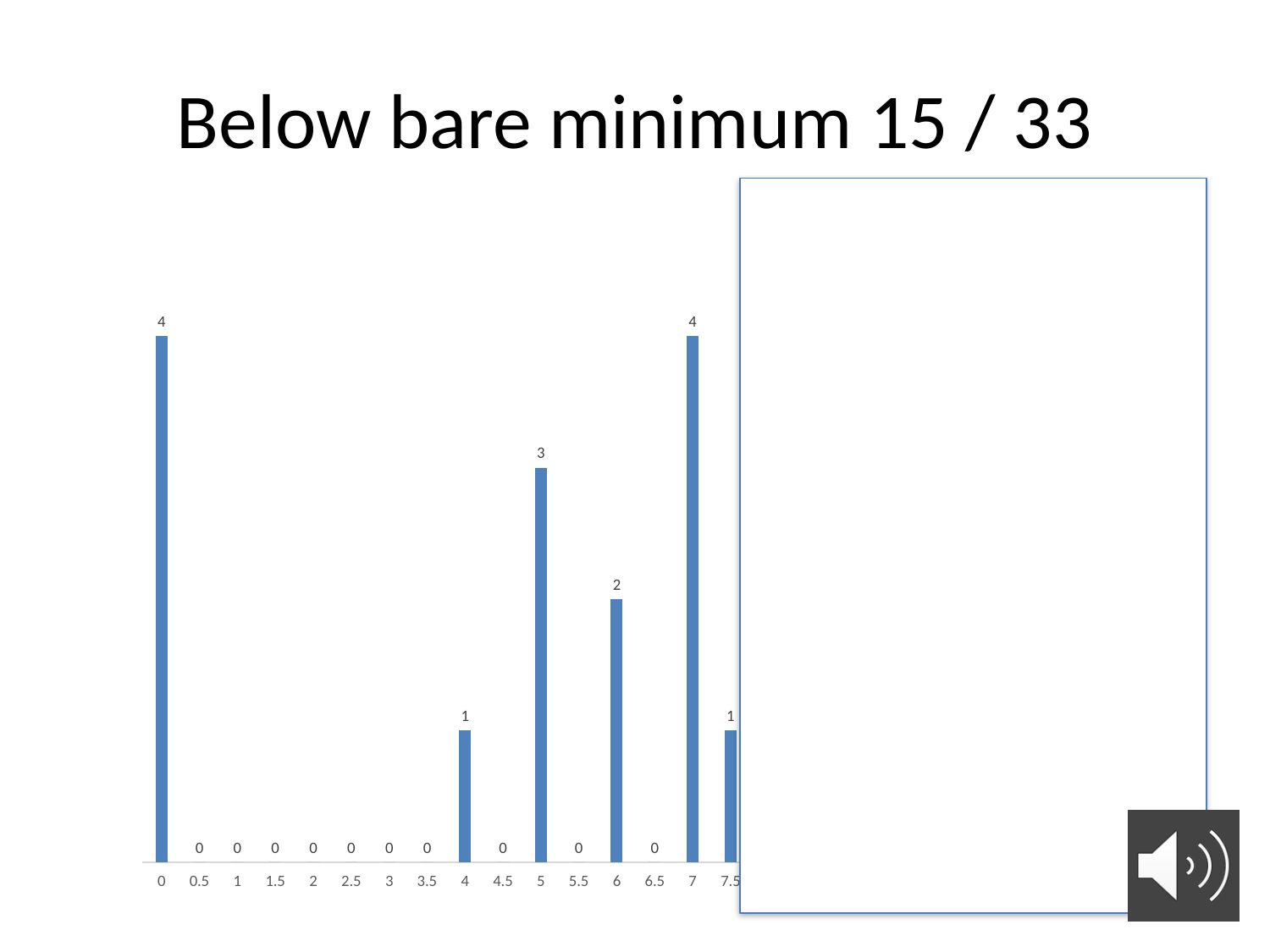
What is the difference between the values for category 5 and category 4? 2 What is the value for category 7? 4 Which is larger, the value for category 5 or the value for category 6? category 5 What is the difference between the values for category 7 and category 6? 2 What kind of chart is shown on the slide? bar chart What is the title of the slide containing the chart? Below bare minimum 15 / 33 What is the value for category 7.5? 1 What is the value for category 2.5? 0 What is the value for category 0? 4 What is the value for category 6? 2 What is the value for category 5? 3 What is the value for category 4? 1